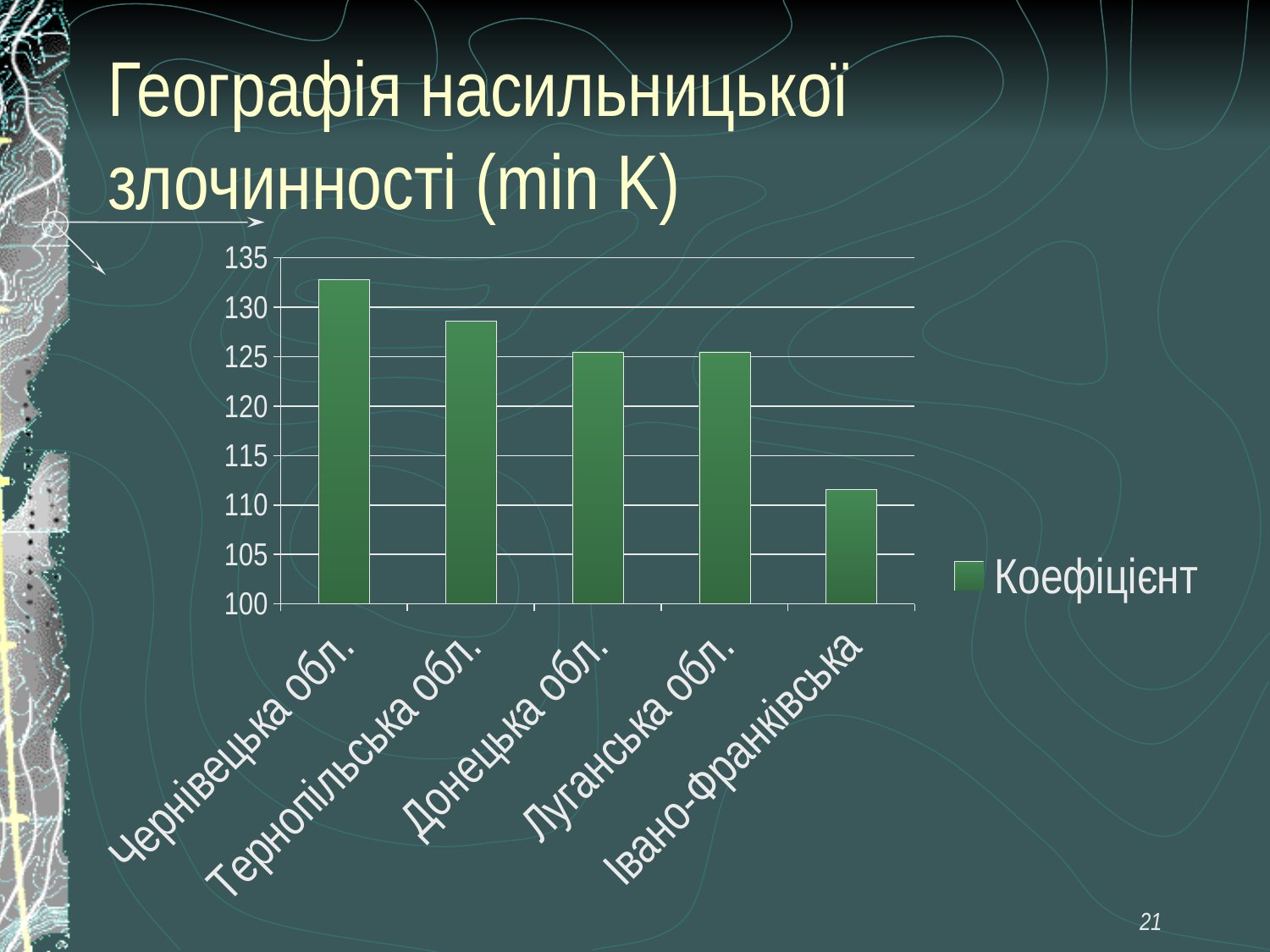
Is the value for Тернопільська обл. greater or less than 125? greater What kind of chart is shown on the slide? bar chart Is the value for Чернівецька обл. greater or less than 130? greater How many regions (categories) are plotted in the chart? 5 Is the value for Донецька обл. greater or less than 130? less What is the name of the series shown in the legend? Коефіцієнт Which region has the lowest value in the chart? Івано-Франківська Do the values rise or fall from left to right along the x axis? fall How many series does the legend list? 1 Which region has the highest value in the chart? Чернівецька обл. Which is larger, the value for Чернівецька обл. or the value for Тернопільська обл.? Чернівецька обл.